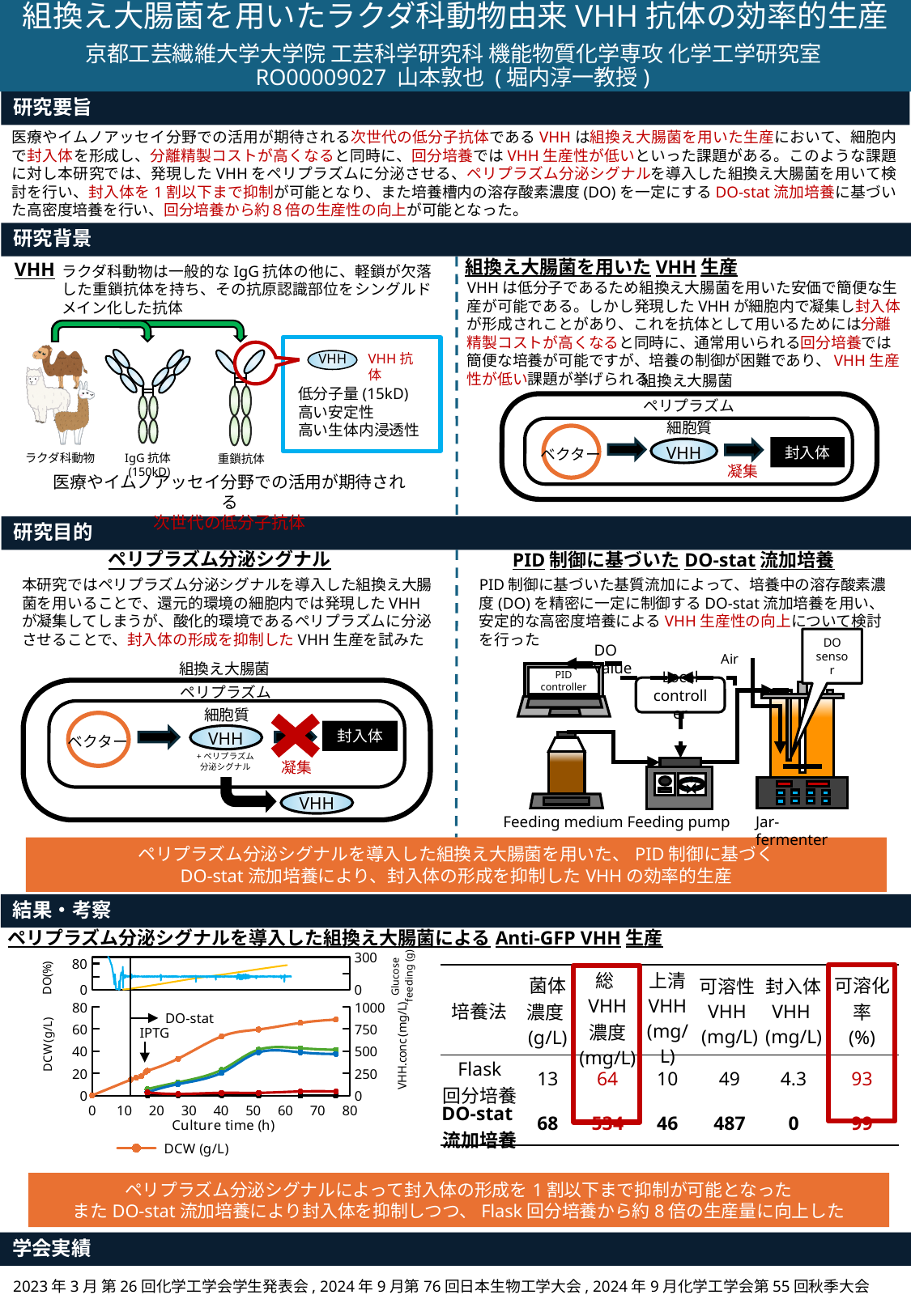
What is the x-axis label of the line chart in the results section? Culture time (h) In the line chart, is the DCW value at about 20 h greater or less than 40 g/L? less In the line chart, is the DCW value at about 75 h greater or less than 60 g/L? greater In the line chart, is the red series value at about 75 h greater or less than 250 mg/L on the right axis? less What is the maximum value shown on the right VHH conc (mg/L) axis of the line chart? 1000 What kind of chart is shown in the results section (結果・考察) of the slide? line chart What series does the legend below the line chart list? DCW (g/L) In the line chart, does the DCW (g/L) value rise or fall as culture time increases? rise